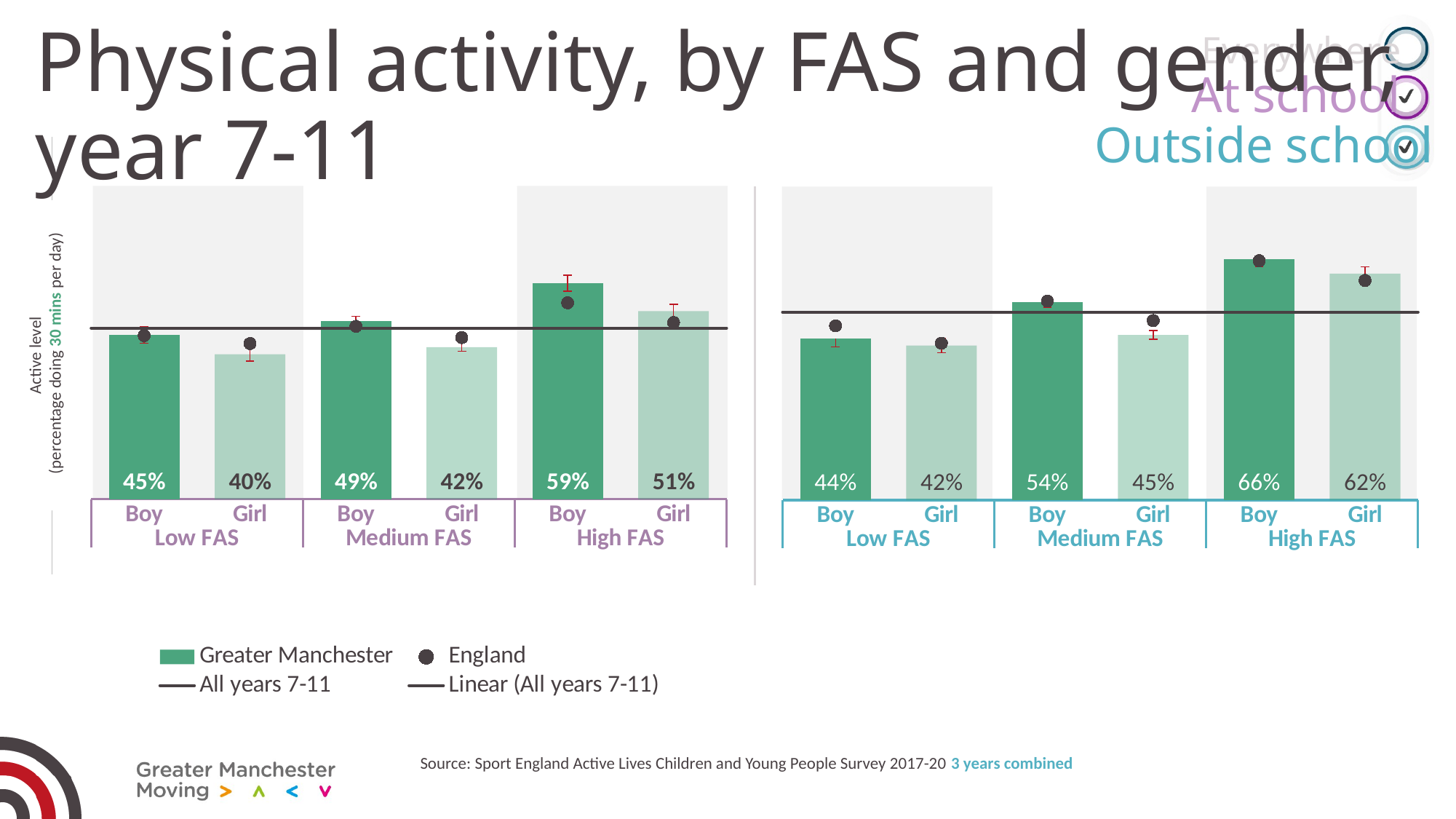
In the 'At school' chart (left), what is the value for Girl in High FAS? 51% In the 'At school' chart (left), which bar has the highest value? Boy, High FAS In the 'Outside school' chart (right), which bar has the lowest value? Girl, Low FAS In the 'At school' chart (left), what is the difference between the Boy and Girl values in High FAS? 8% How many entries does the legend list? 4 How many bars are plotted in the 'Outside school' chart (right)? 6 In the 'Outside school' chart (right), what is the value for Boy in Medium FAS? 54% In the 'Outside school' chart (right), what is the value for Girl in Low FAS? 42% In the 'Outside school' chart (right), what is the difference between the Boy and Girl values in Medium FAS? 9% Which is larger: the Girl value in Medium FAS in the 'At school' chart or the Girl value in Medium FAS in the 'Outside school' chart? Outside school What kind of chart is used on this slide? Bar chart In the 'At school' chart (left), what is the value for Boy in Low FAS? 45%